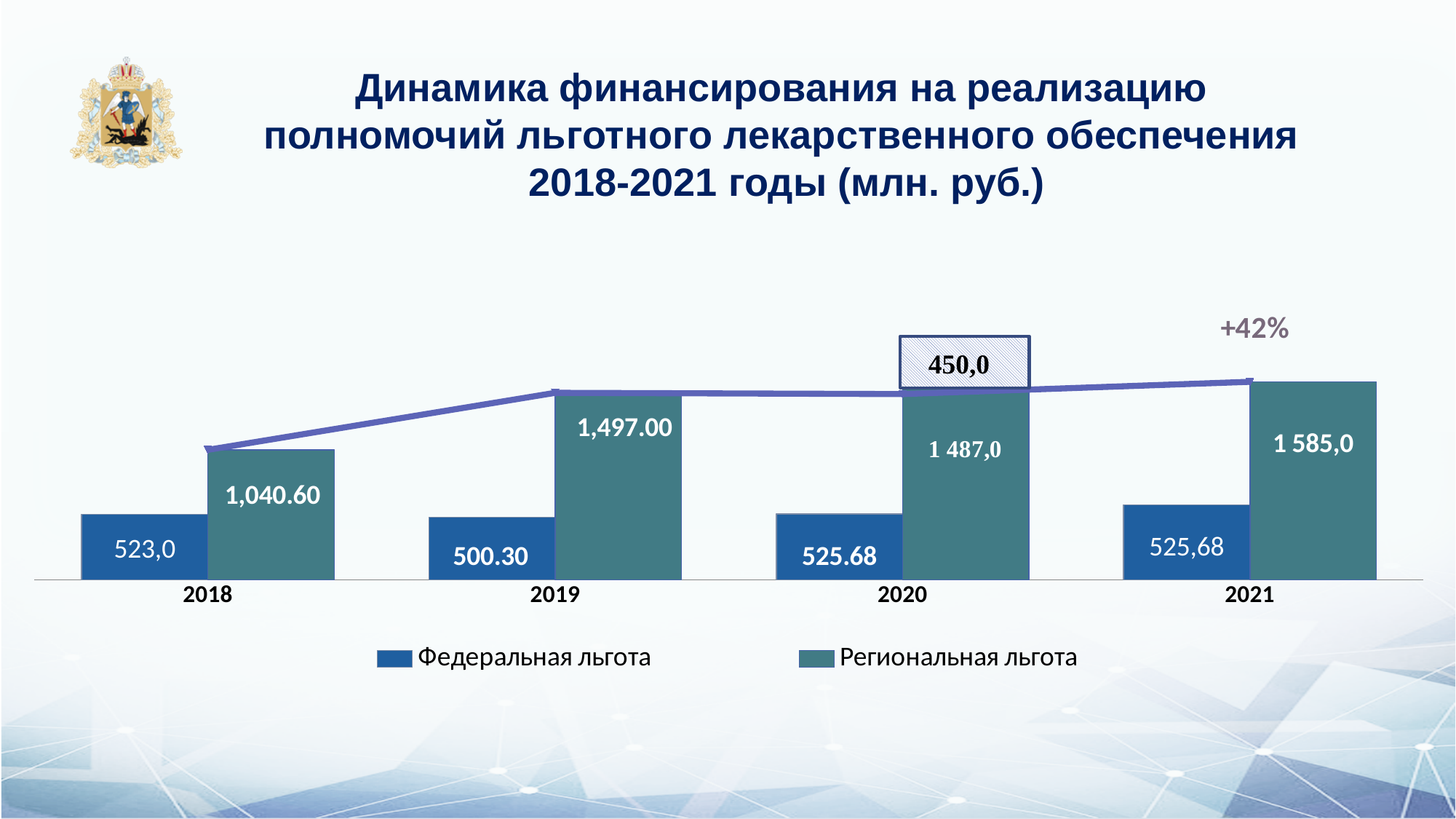
In which year is the Федеральная льгота value lowest? 2019 How many years are shown on the x axis? 4 What is the value for Федеральная льгота in 2020? 525.68 What kind of chart is shown on the slide? Combination bar and line chart What percentage change is annotated above the 2021 bars? +42% What is the value for Региональная льгота in 2018? 1,040.60 How many series does the legend list? 2 Which is larger in 2020: Федеральная льгота or Региональная льгота? Региональная льгота What is the value for Региональная льгота in 2021? 1 585,0 What is the value for Региональная льгота in 2019? 1,497.00 What is the value for Федеральная льгота in 2018? 523,0 In which year is the Региональная льгота value highest? 2021